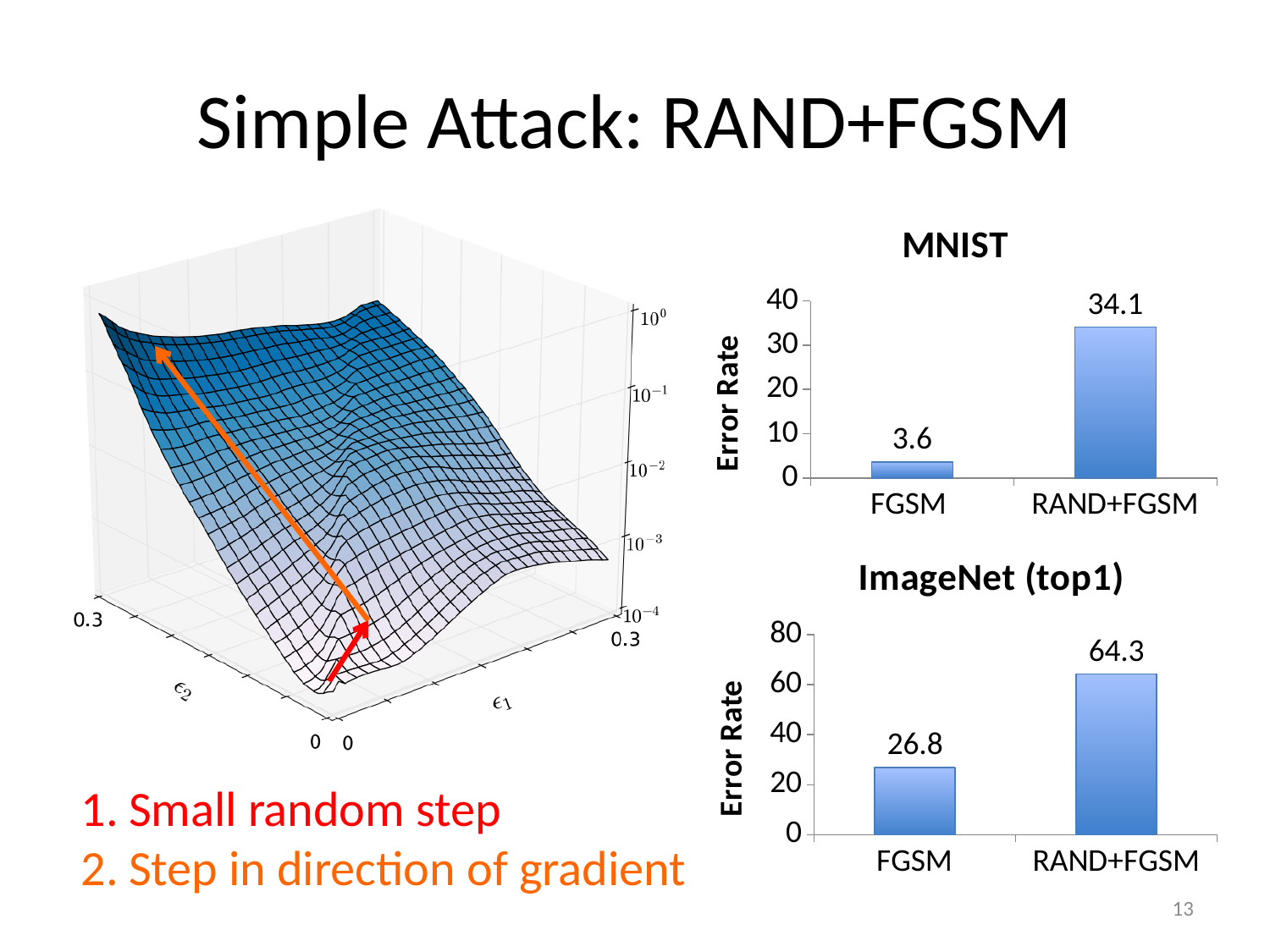
In the ImageNet (top1) chart, which attack has the lower error rate? FGSM In the MNIST chart, what is the difference in error rate between RAND+FGSM and FGSM? 30.5 In the MNIST chart, what is the error rate for RAND+FGSM? 34.1 In the ImageNet (top1) chart, what is the error rate for FGSM? 26.8 In the ImageNet (top1) chart, is the error rate for RAND+FGSM greater or less than 60? greater What type of chart is the ImageNet (top1) chart? bar chart In the MNIST chart, what is the error rate for FGSM? 3.6 In the ImageNet (top1) chart, what is the difference in error rate between RAND+FGSM and FGSM? 37.5 How many categories are shown in the MNIST chart? 2 What is the y-axis label of the MNIST chart? Error Rate In the MNIST chart, which attack has the higher error rate? RAND+FGSM In the ImageNet (top1) chart, what is the error rate for RAND+FGSM? 64.3